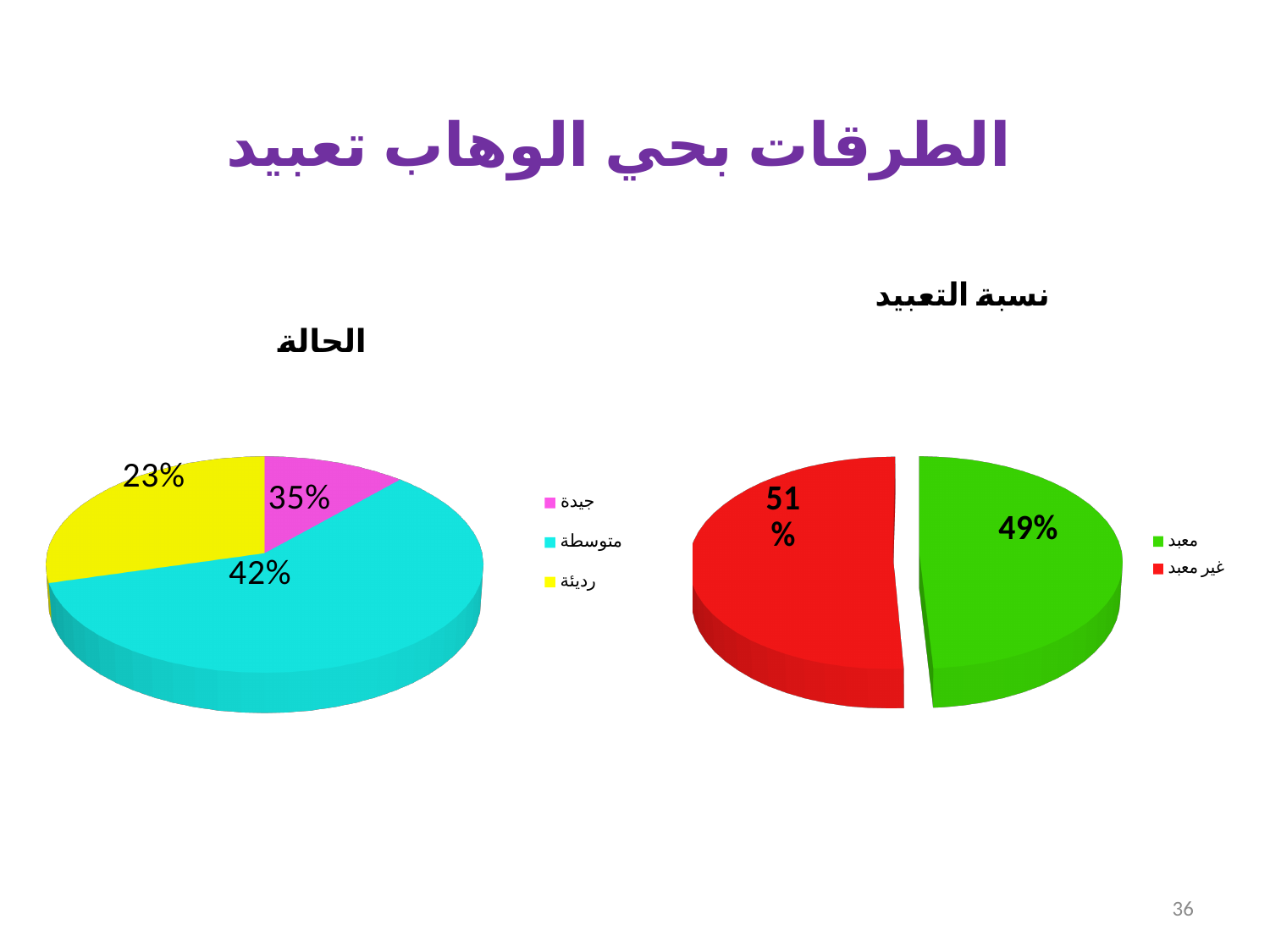
In the chart titled "نسبة التعبيد", what percentage is shown for "غير معبد"? 51% In the chart titled "الحالة", what percentage is shown for "متوسطة"? 42% In the chart titled "الحالة", what percentage is shown for "جيدة"? 35% In the chart titled "الحالة", what percentage is shown for "رديئة"? 23% In the chart titled "الحالة", which category has the largest slice? متوسطة In the chart titled "نسبة التعبيد", which is larger, "معبد" or "غير معبد"? غير معبد In the chart titled "نسبة التعبيد", what colour is the "معبد" slice? Green In the chart titled "الحالة", what is the difference between the "متوسطة" and "رديئة" percentages? 19% In the chart titled "الحالة", how many slices does the pie have? 3 In the chart titled "نسبة التعبيد", what percentage is shown for "معبد"? 49% What type of chart is the chart titled "نسبة التعبيد"? Pie chart